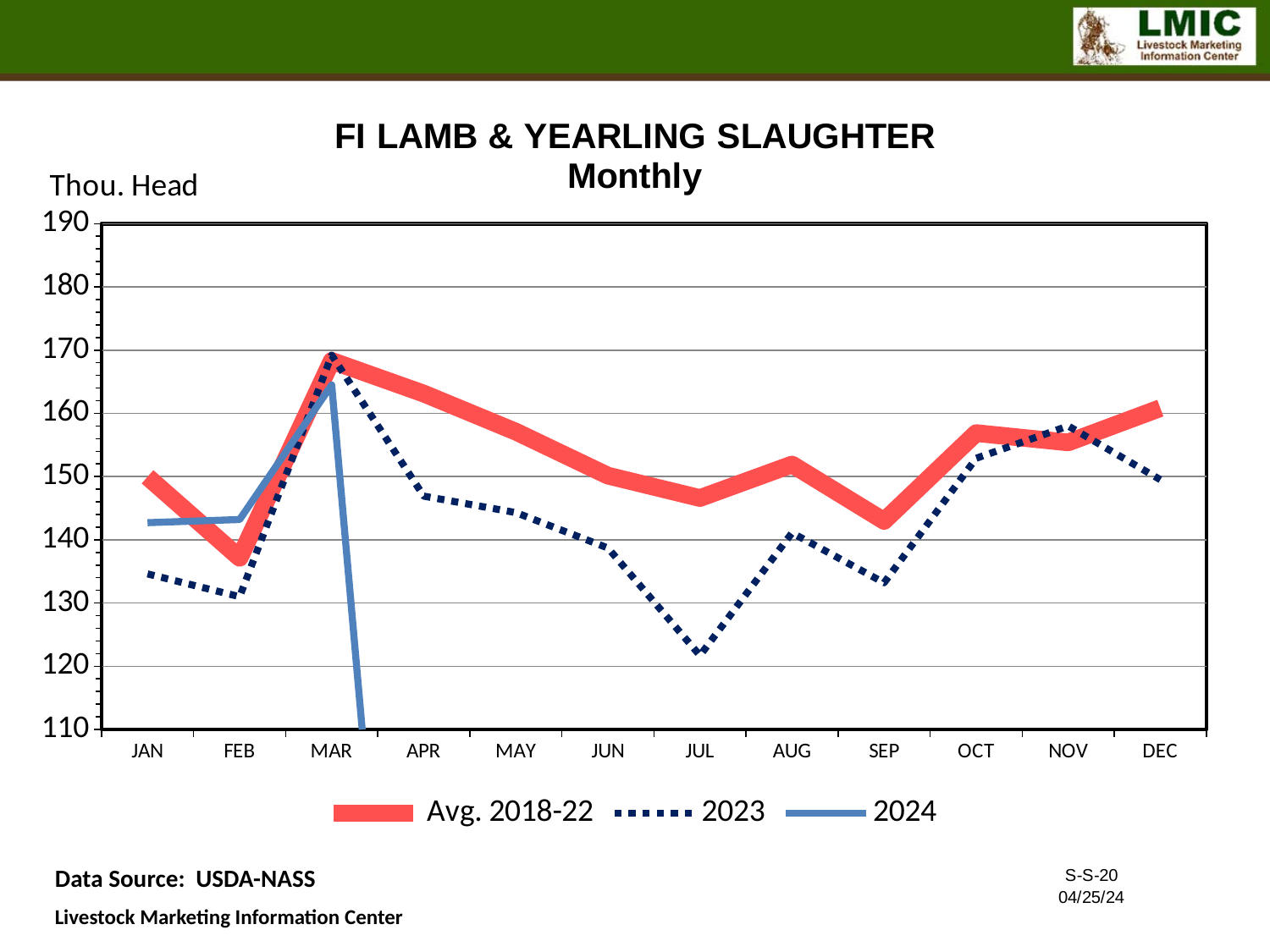
In which month does the 2023 series reach its highest value? MAR Is the Avg. 2018-22 value for MAR greater or less than 160? greater Is the 2023 value for JUL greater or less than 130? less Is the 2023 value for JAN greater or less than 140? less How many series does the legend list? 3 How many months are shown along the x axis? 12 In which month does the 2023 series reach its lowest value? JUL In JUL, which is larger: the Avg. 2018-22 value or the 2023 value? Avg. 2018-22 In which month is the Avg. 2018-22 series at its lowest? FEB What unit label is shown above the y axis? Thou. Head What kind of chart is shown on the slide? line chart Does the 2023 series rise or fall from MAR to JUL? fall